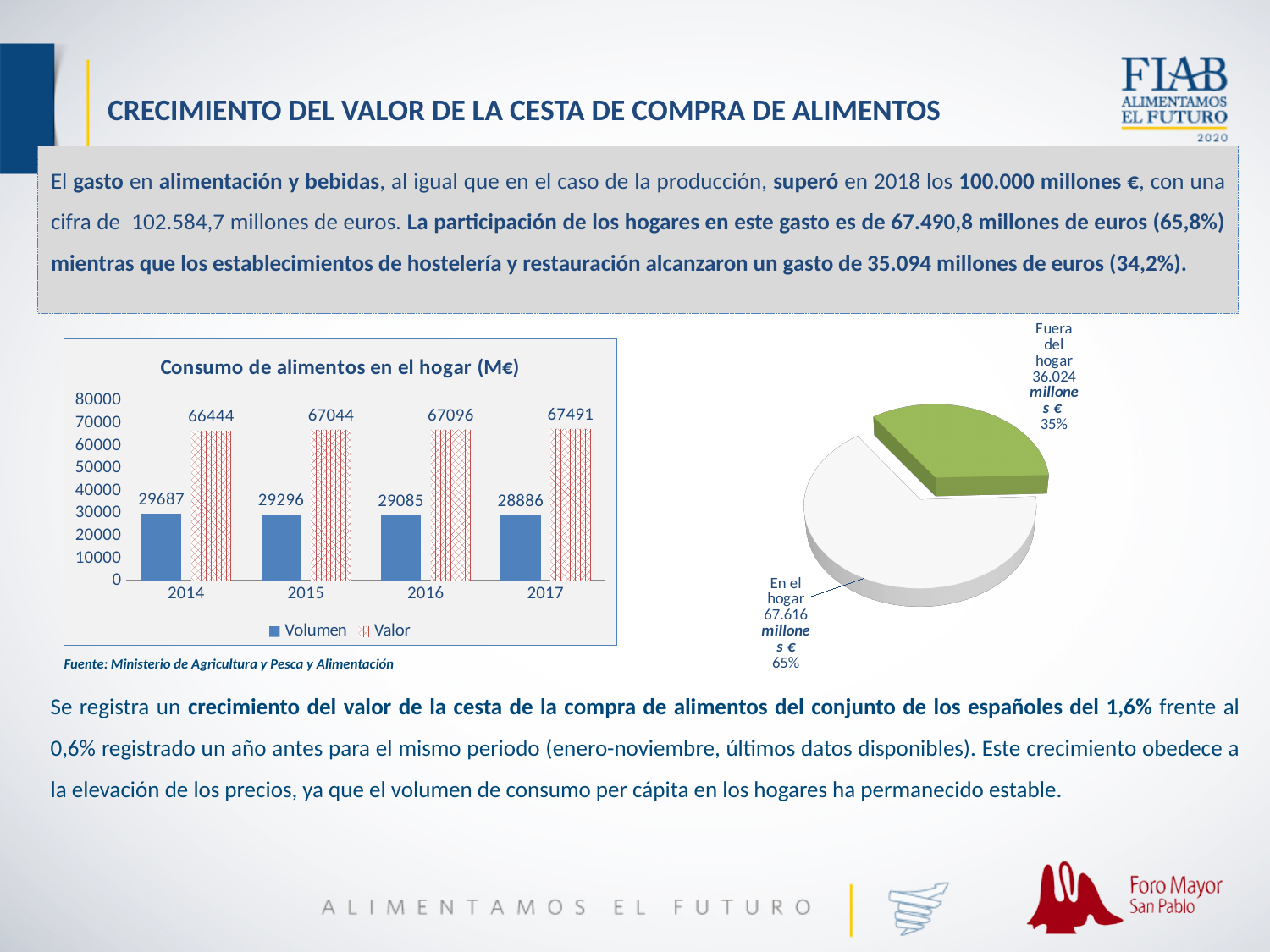
In the bar chart 'Consumo de alimentos en el hogar (M€)', is the Volumen value for 2015 larger or smaller than the Volumen value for 2016? larger In the bar chart 'Consumo de alimentos en el hogar (M€)', what is the Volumen value for 2014? 29687 In the bar chart 'Consumo de alimentos en el hogar (M€)', how many years are shown on the x axis? 4 In the bar chart 'Consumo de alimentos en el hogar (M€)', what is the difference between the Valor values for 2017 and 2014? 1047 What kind of chart is the chart on the right side of the slide? pie chart In the bar chart 'Consumo de alimentos en el hogar (M€)', what is the Valor value for 2017? 67491 In the pie chart on the right, what share does 'Fuera del hogar' represent? 35% In the bar chart 'Consumo de alimentos en el hogar (M€)', which year has the lowest Volumen? 2017 In the pie chart on the right, what is the value shown for 'En el hogar'? 67.616 millones € In the bar chart 'Consumo de alimentos en el hogar (M€)', which year has the highest Valor? 2017 In the bar chart 'Consumo de alimentos en el hogar (M€)', does the Volumen series rise or fall from 2015 to 2017? fall In the bar chart 'Consumo de alimentos en el hogar (M€)', how many series does the legend list? 2